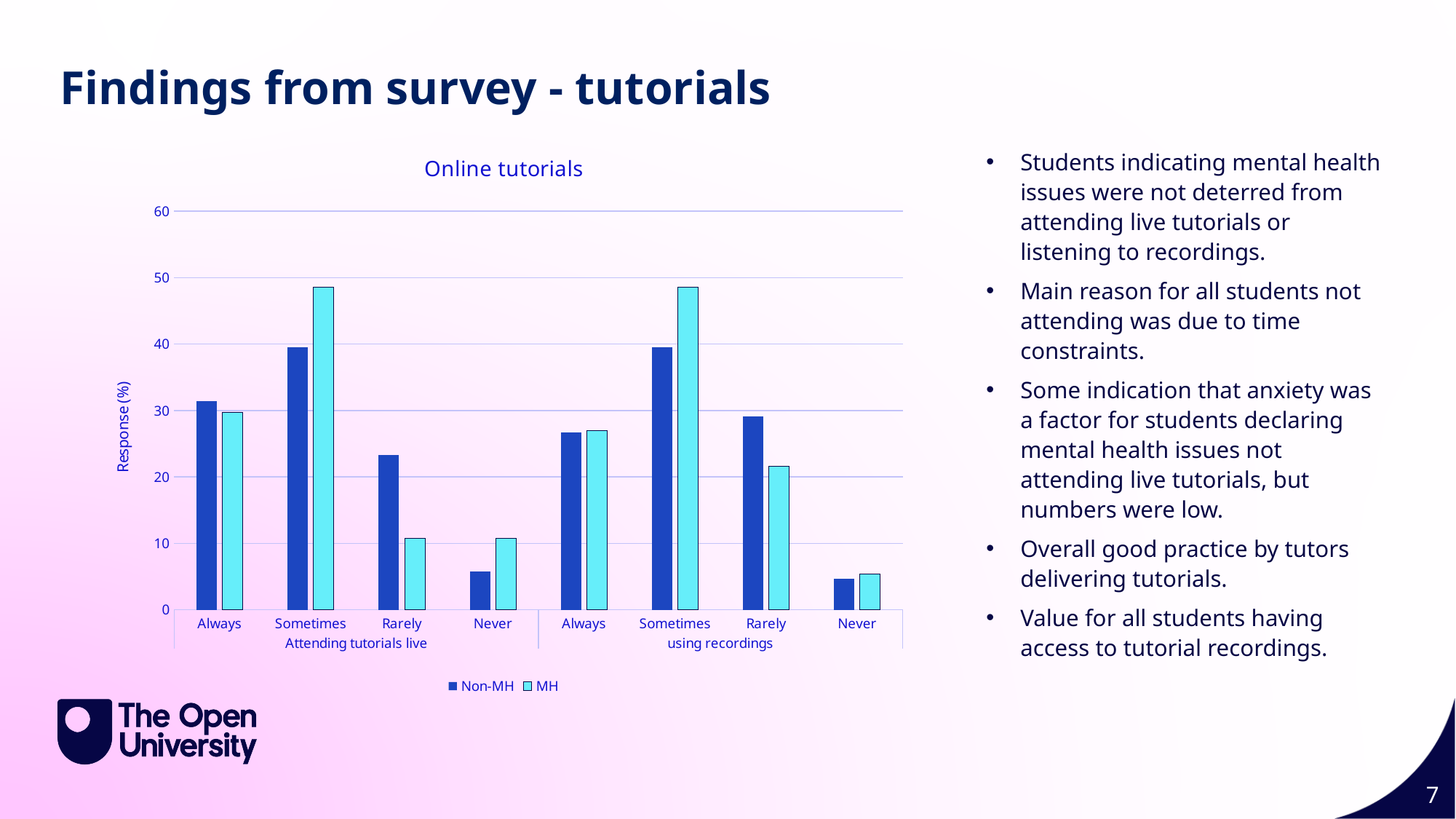
For 'Rarely' under 'Attending tutorials live', which series has the larger value, Non-MH or MH? Non-MH Is the Non-MH value for 'Never' under 'Attending tutorials live' greater or less than 10? less For 'Never' under 'Attending tutorials live', which series has the larger value, Non-MH or MH? MH Under 'Attending tutorials live', which category has the highest MH value? Sometimes What is the label on the vertical axis of the 'Online tutorials' chart? Response (%) Is the Non-MH value for 'Sometimes' under 'using recordings' greater or less than 30? greater What kind of chart is shown on the slide? Bar chart How many categories are shown under the 'Attending tutorials live' group on the x axis? 4 Is the MH value for 'Sometimes' under 'Attending tutorials live' greater or less than 40? greater What are the two series named in the legend of the 'Online tutorials' chart? Non-MH and MH Under 'using recordings', which category has the lowest Non-MH value? Never How many series does the legend of the 'Online tutorials' chart list? 2